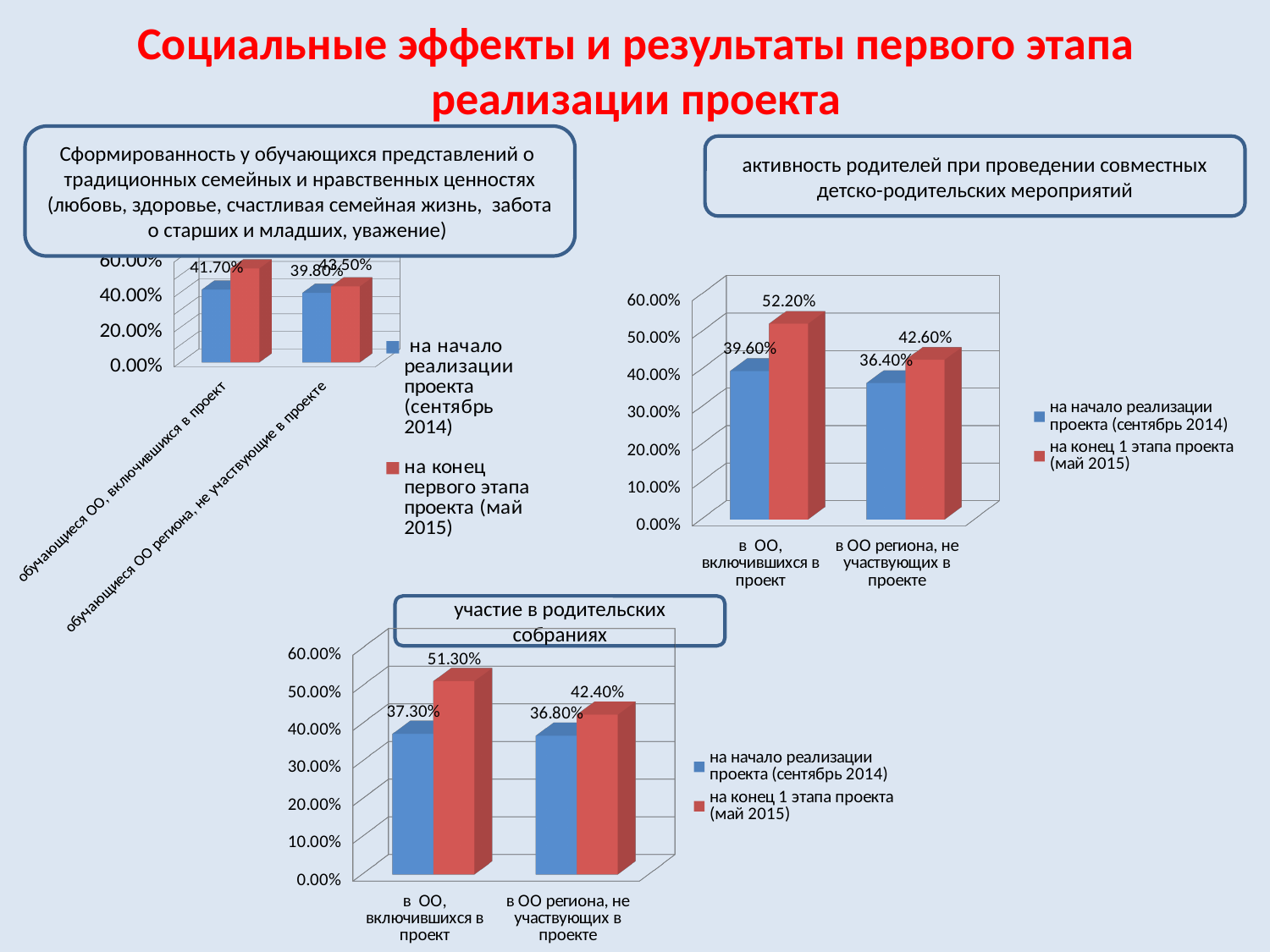
On the chart titled 'участие в родительских собраниях', which bar is the lowest? в ОО региона, не участвующих в проекте, на начало реализации проекта (сентябрь 2014) What kind of chart is the chart titled 'активность родителей при проведении совместных детско-родительских мероприятий'? bar chart On the chart titled 'участие в родительских собраниях', what is the value for 'в ОО региона, не участвующих в проекте' at the end of the first stage (май 2015)? 42.40% On the chart titled 'участие в родительских собраниях', what is the value for 'в ОО, включившихся в проект' at the start of the project (сентябрь 2014)? 37.30% On the chart titled 'активность родителей при проведении совместных детско-родительских мероприятий', which bar is the highest? в ОО, включившихся в проект, на конец 1 этапа проекта (май 2015) On the chart titled 'участие в родительских собраниях', is the May 2015 value for 'в ОО, включившихся в проект' greater or less than 50.00%? greater On the chart titled 'активность родителей при проведении совместных детско-родительских мероприятий', what is the value for 'в ОО, включившихся в проект' at the end of the first stage (май 2015)? 52.20% On the chart titled 'активность родителей при проведении совместных детско-родительских мероприятий', what is the difference between the May 2015 and September 2014 values for 'в ОО, включившихся в проект'? 12.60% On the top-left chart, what is the value for 'обучающиеся ОО региона, не участвующие в проекте' at the end of the first stage (май 2015)? 43.50% On the chart titled 'активность родителей при проведении совместных детско-родительских мероприятий', what is the value for 'в ОО региона, не участвующих в проекте' at the start of the project (сентябрь 2014)? 36.40% On the chart titled 'участие в родительских собраниях', what is the difference between the May 2015 values for 'в ОО, включившихся в проект' and 'в ОО региона, не участвующих в проекте'? 8.90% How many series does the legend of the chart titled 'участие в родительских собраниях' list? 2